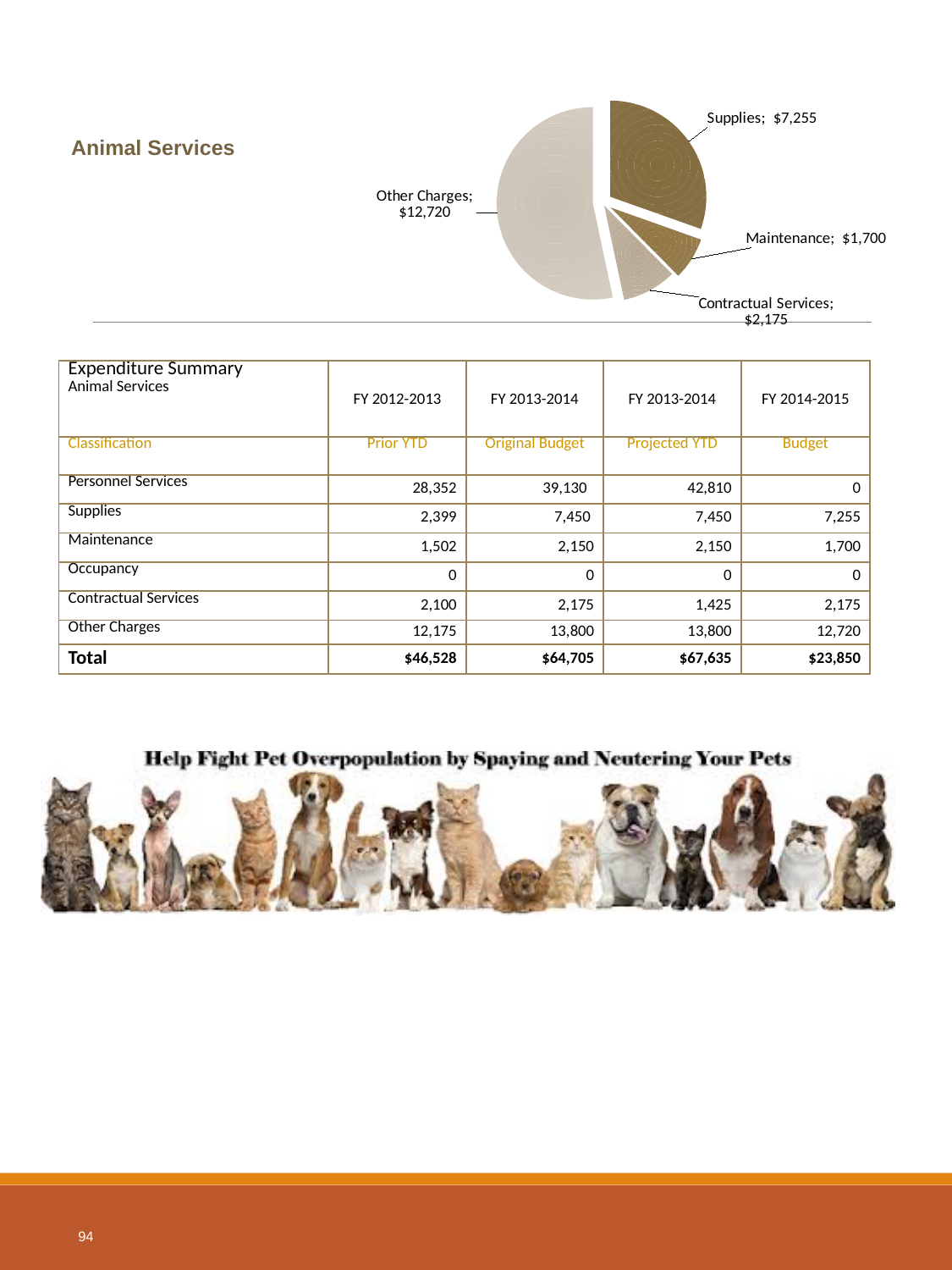
What is the value of the Other Charges slice in the pie chart? $12,720 What type of chart is shown on the slide? Pie chart What is the difference between the Contractual Services and Maintenance values in the pie chart? $475 Which category has the smallest slice in the pie chart? Maintenance What is the value of the Contractual Services slice in the pie chart? $2,175 How many slices does the pie chart have? 4 Which is larger in the pie chart, Supplies or Contractual Services? Supplies What is the total of all slices in the pie chart? $23,850 What is the difference between the Other Charges and Supplies values in the pie chart? $5,465 What is the value of the Supplies slice in the pie chart? $7,255 Which category has the largest slice in the pie chart? Other Charges What is the value of the Maintenance slice in the pie chart? $1,700